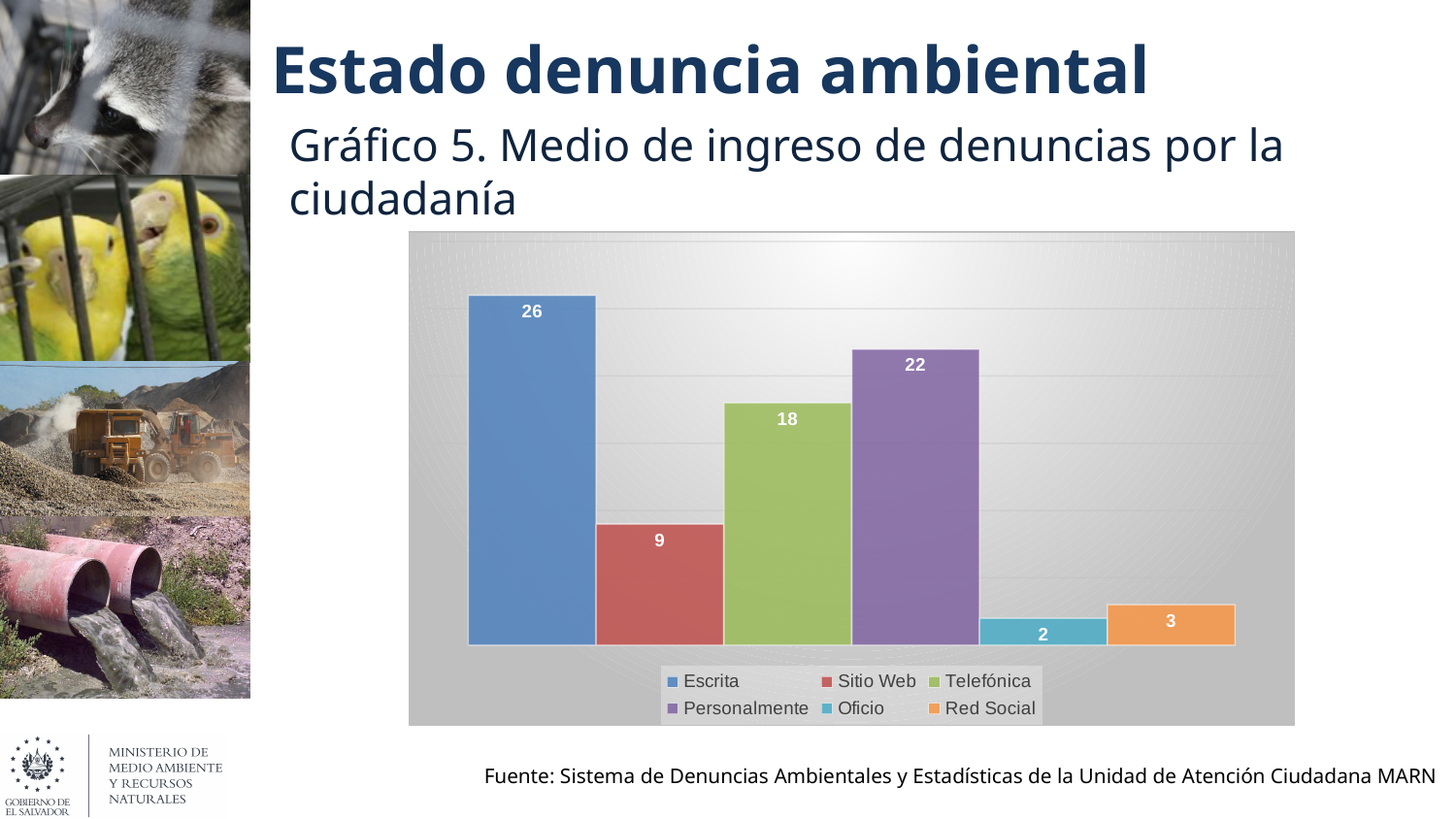
What kind of chart is shown on the slide? Bar chart What is the value for Oficio? 2 How many series does the legend list? 6 Which category has the highest value? Escrita What colour is the bar for Red Social? Orange Which category has the lowest value? Oficio What is the value for Escrita? 26 What is the value for Telefónica? 18 Which is larger, the value for Telefónica or the value for Sitio Web? Telefónica What is the value for Personalmente? 22 What is the value for Sitio Web? 9 What is the difference between the values for Escrita and Personalmente? 4